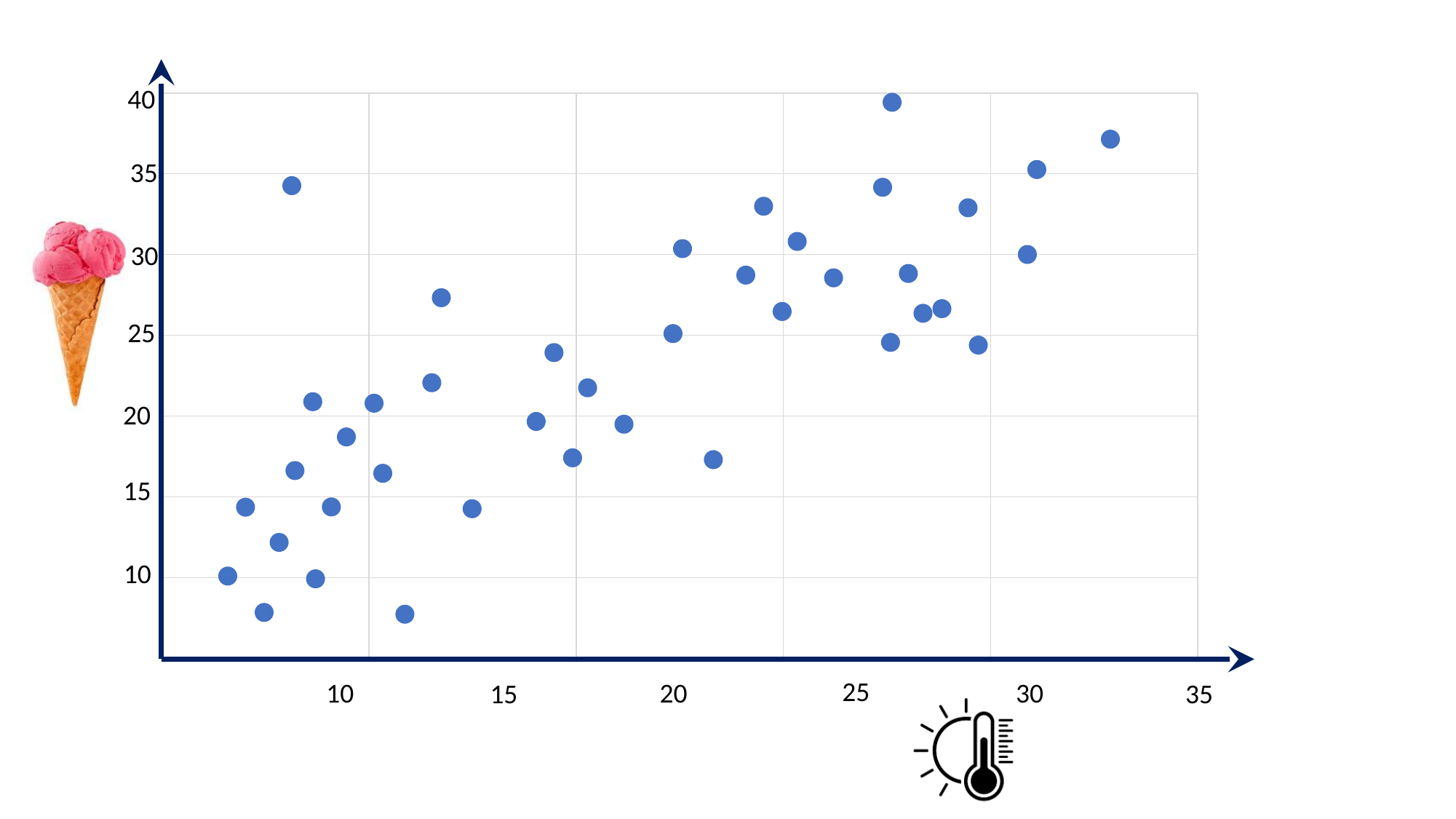
What kind of chart is shown on the slide? scatter chart Is the y value of the lowest point on the chart greater or less than 10? less Is the x value of the highest point on the chart greater or less than 30? less How many data points are plotted on the chart? 40 What colour are the plotted points? blue Is the x value of the rightmost point greater or less than 30? greater Which has the larger y value, the leftmost point or the rightmost point? the rightmost point What is the highest tick label shown on the y axis? 40 Do the plotted values generally rise or fall as the x value increases? rise